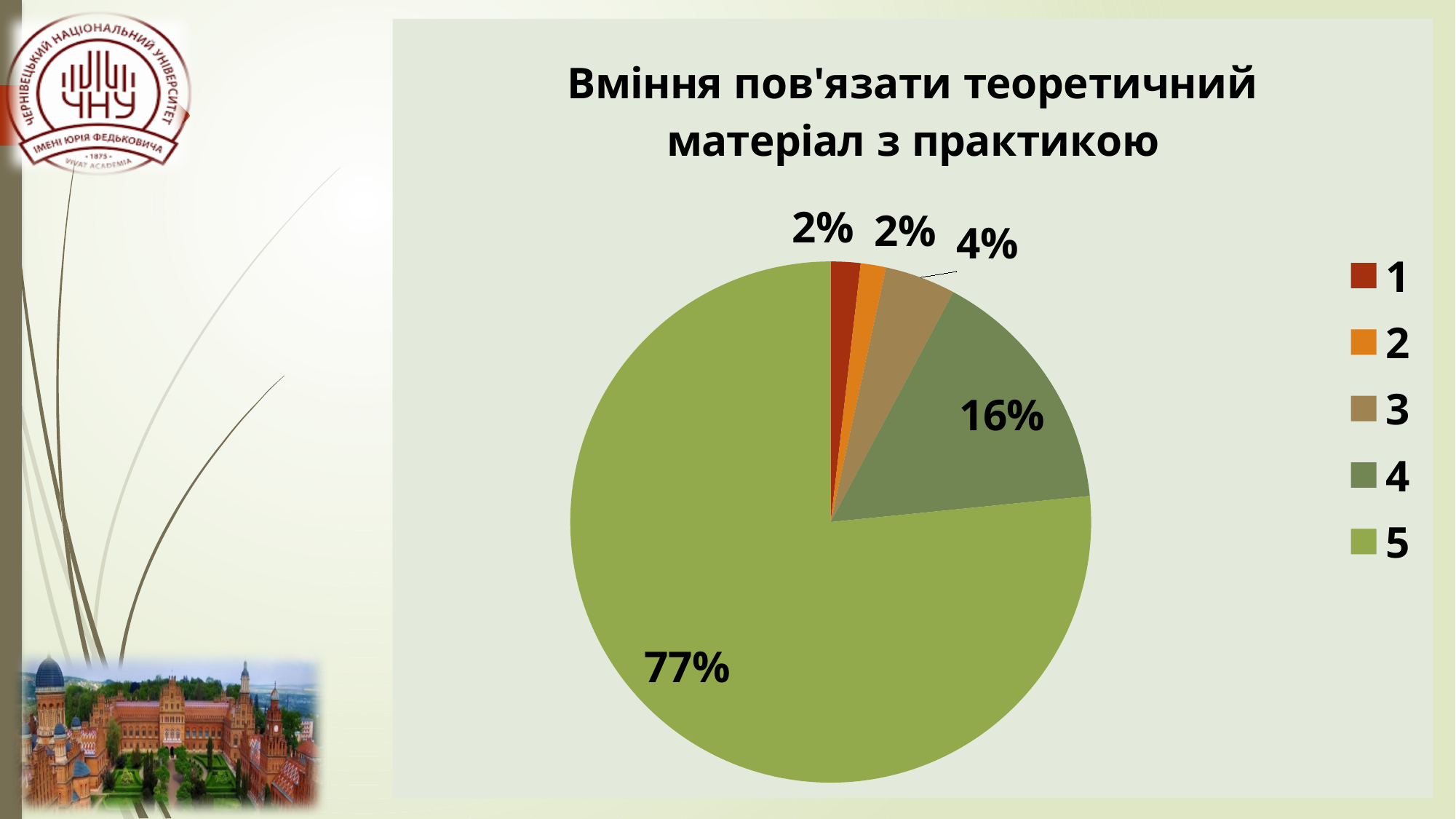
What share of the pie does category 1 have? 2% What colour is the slice for category 5? green What is the difference between the shares of category 5 and category 4? 61% What share of the pie does category 3 have? 4% Which category has the largest slice of the pie? 5 What is the difference between the shares of category 3 and category 2? 2% What share of the pie does category 5 have? 77% How many categories does the legend list? 5 What is the title of the chart? Вміння пов'язати теоретичний матеріал з практикою What kind of chart is shown on the slide? pie chart What share of the pie does category 4 have? 16% Which is larger, the share of category 4 or the share of category 3? 4